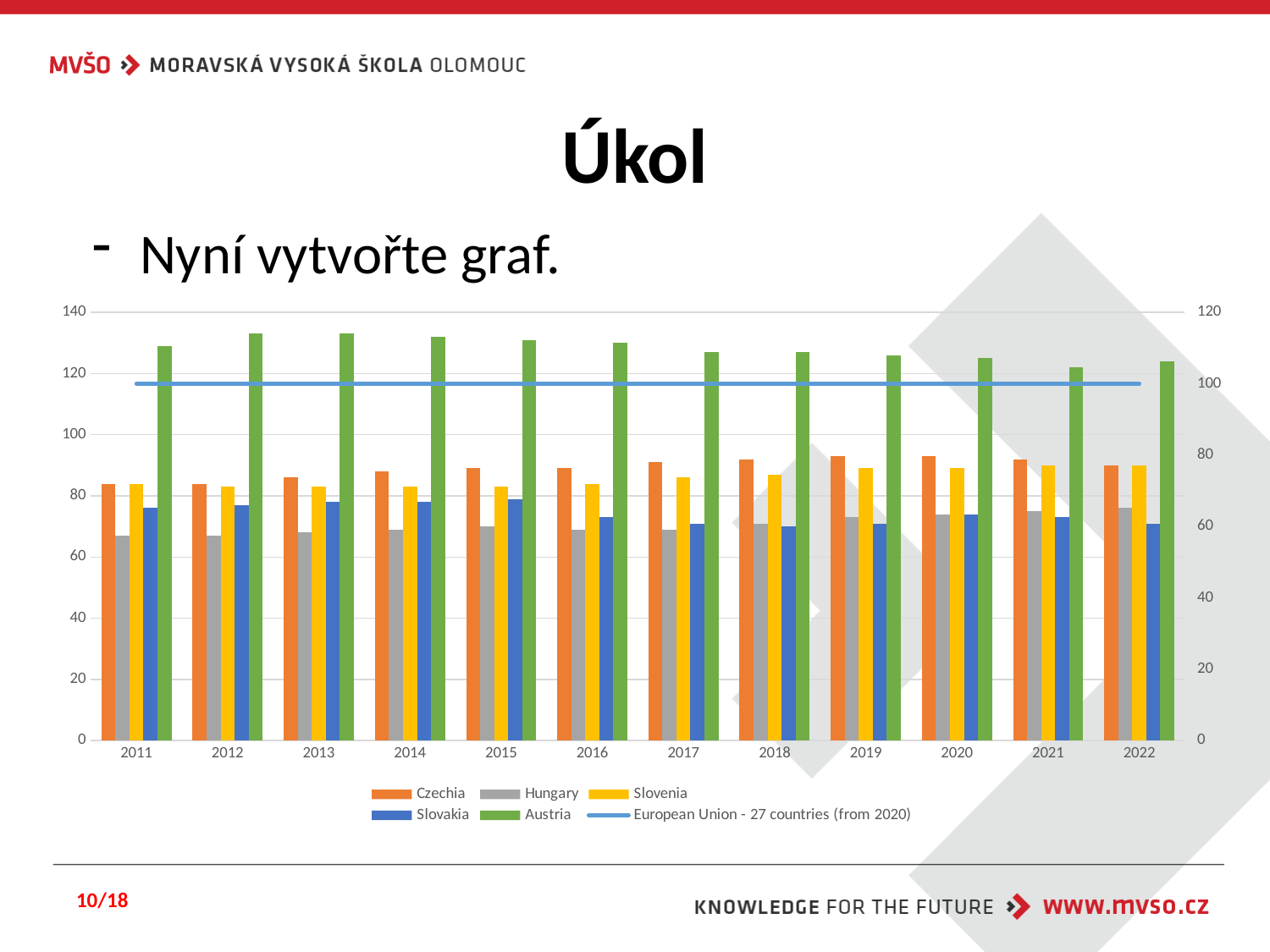
Do the bars for Hungary rise or fall from 2011 to 2022? rise Which country has the highest bar in 2011? Austria What kind of chart is shown on the slide? Bar chart (with a line series) Is the value for Slovakia in 2022 greater or less than 80? less Is the value for Hungary in 2011 greater or less than 80? less Which series is plotted as a line rather than bars? European Union - 27 countries (from 2020) Which country has the lowest bar in 2011? Hungary Which country has the lowest bar in 2022? Slovakia How many years are shown on the x axis of the chart? 12 How many series does the chart legend list? 6 Is the value for Austria in 2011 greater or less than 120? greater Which is larger in 2011, the bar for Czechia or the bar for Hungary? Czechia